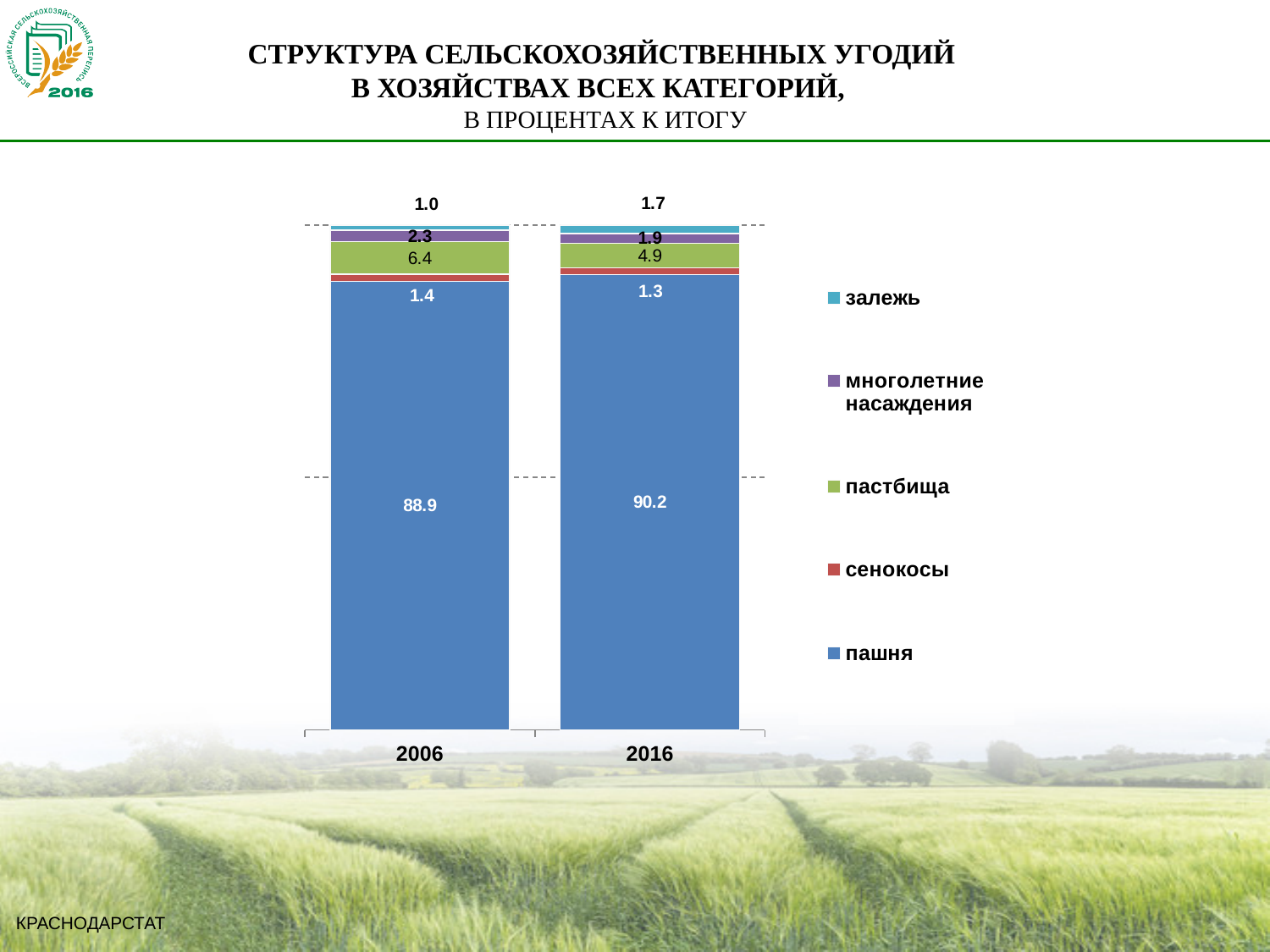
Which series has the largest share in 2016? пашня Which is larger: the value for пашня in 2006 or in 2016? 2016 What is the value for пашня in 2016? 90.2 Which series has the smallest share in 2006? залежь What is the value for пастбища in 2016? 4.9 What is the value for залежь in 2006? 1.0 How many years (categories) are shown on the x axis? 2 What is the value for многолетние насаждения in 2016? 1.9 What is the value for пашня in 2006? 88.9 What kind of chart is shown on the slide? stacked bar chart By how much did the value for пастбища change from 2006 to 2016? 1.5 How many series does the legend list? 5